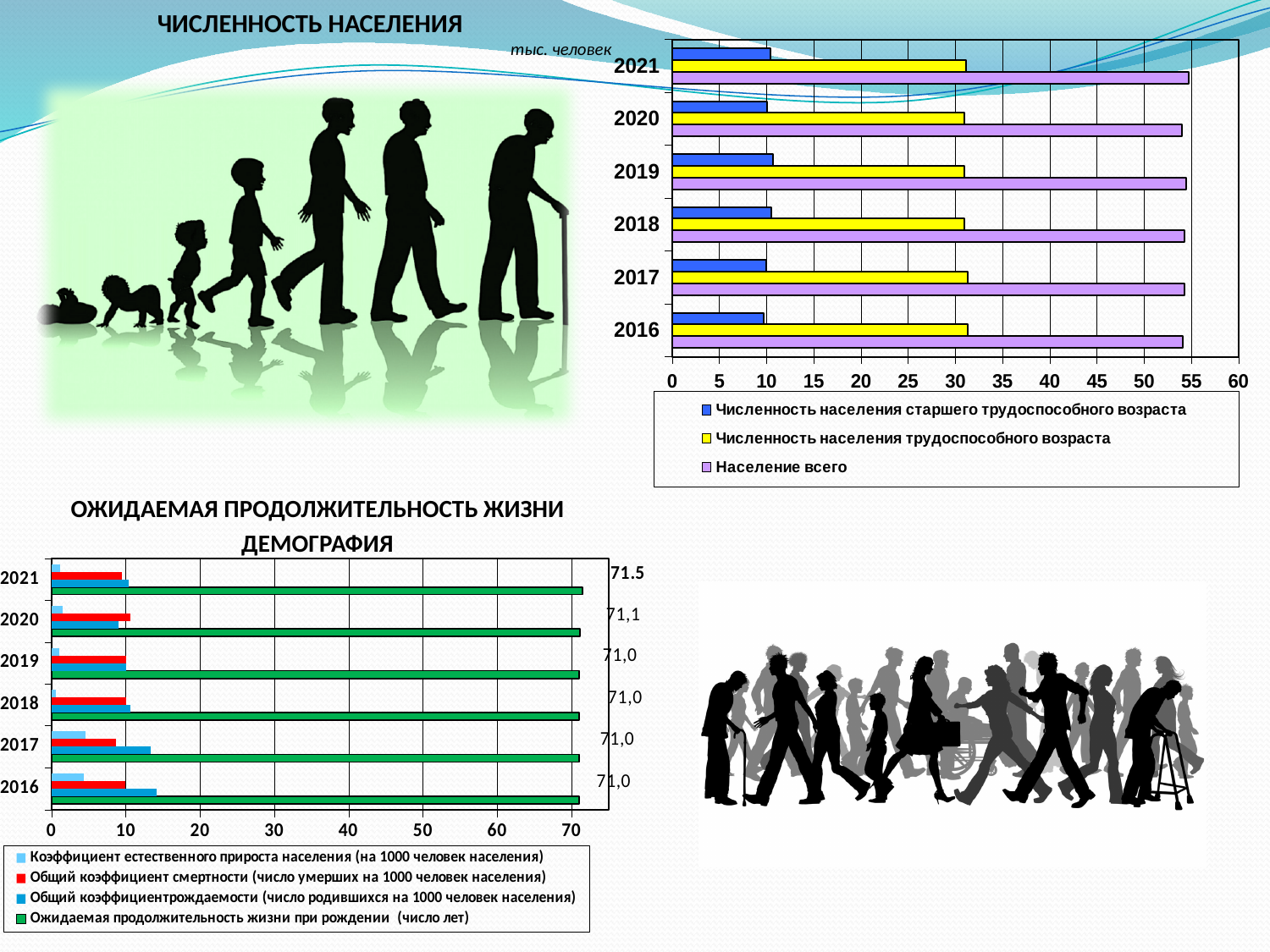
In the 'ДЕМОГРАФИЯ' chart at the bottom left, what is the value of 'Ожидаемая продолжительность жизни при рождении' for 2021? 71.5 How many series does the legend of the 'ЧИСЛЕННОСТЬ НАСЕЛЕНИЯ' chart list? 3 In the 'ЧИСЛЕННОСТЬ НАСЕЛЕНИЯ' chart, is the value of 'Численность населения трудоспособного возраста' for 2019 greater or less than 25? greater What kind of chart is the 'ЧИСЛЕННОСТЬ НАСЕЛЕНИЯ' chart at the top right of the slide? bar chart In the 'ДЕМОГРАФИЯ' chart at the bottom left, what is the value of 'Ожидаемая продолжительность жизни при рождении' for 2020? 71,1 In the 'ДЕМОГРАФИЯ' chart at the bottom left, which year has the highest 'Ожидаемая продолжительность жизни при рождении'? 2021 What unit is indicated above the 'ЧИСЛЕННОСТЬ НАСЕЛЕНИЯ' chart? тыс. человек In the 'ДЕМОГРАФИЯ' chart at the bottom left, which is larger for 2016: 'Общий коэффициент смертности' or 'Общий коэффициент рождаемости'? Общий коэффициент рождаемости How many years are shown on the 'ЧИСЛЕННОСТЬ НАСЕЛЕНИЯ' chart? 6 In the 'ЧИСЛЕННОСТЬ НАСЕЛЕНИЯ' chart, is the value of 'Численность населения старшего трудоспособного возраста' for 2016 greater or less than 15? less How many series does the legend of the 'ДЕМОГРАФИЯ' chart at the bottom left list? 4 In the 'ЧИСЛЕННОСТЬ НАСЕЛЕНИЯ' chart, is the value of 'Население всего' for 2021 greater or less than 50? greater